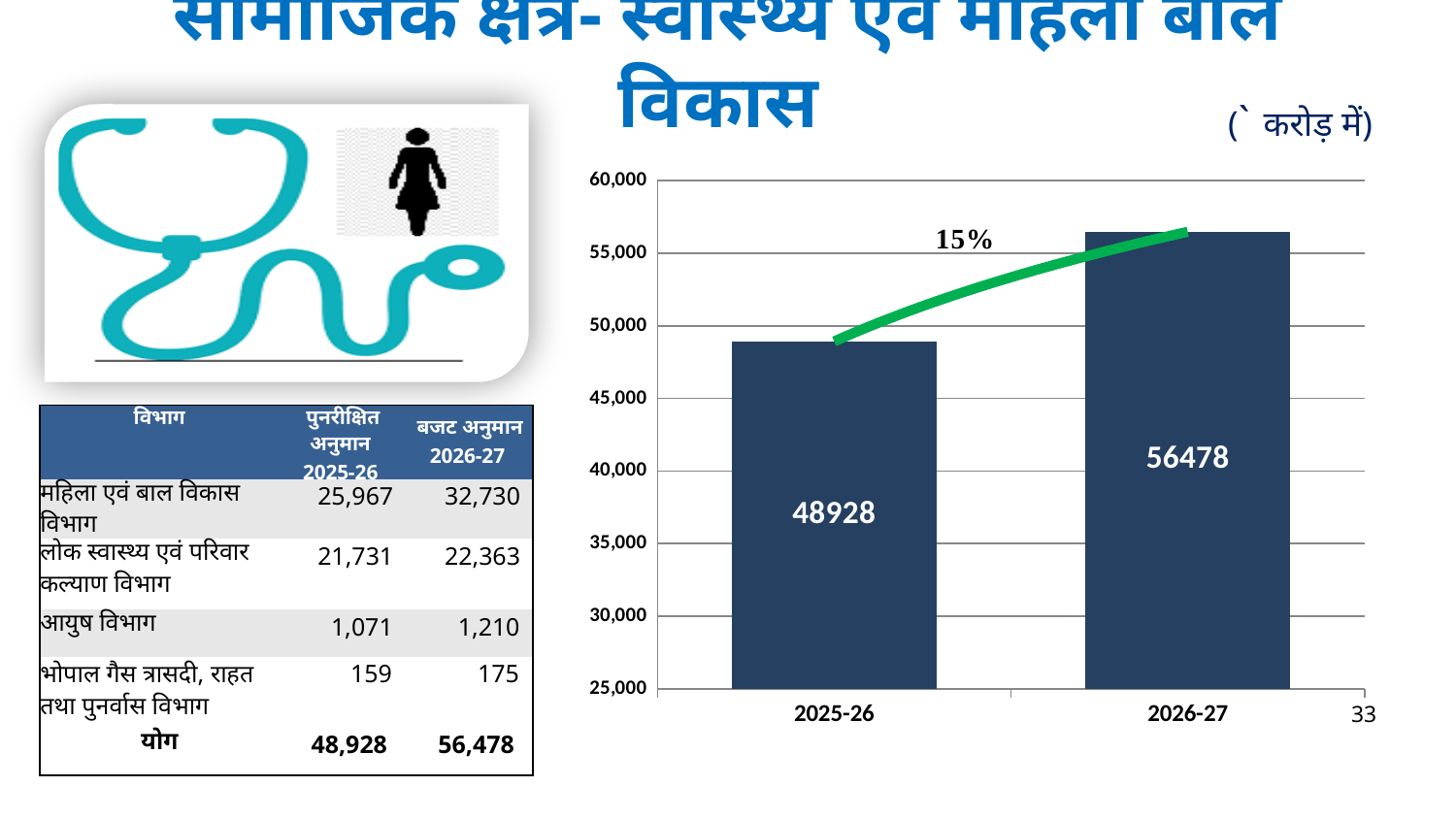
What percentage growth is annotated on the chart between the two bars? 15% How many bars are shown in the chart? 2 What type of chart is shown on the slide? bar chart Which year has the higher value in the bar chart? 2026-27 What is the value for 2026-27 in the bar chart? 56478 Is the value for 2026-27 larger or smaller than the value for 2025-26? larger What is the value for 2025-26 in the bar chart? 48928 Is the value for 2025-26 greater or less than 50,000? less Do the values rise or fall from 2025-26 to 2026-27? rise Which year has the lower value in the bar chart? 2025-26 What is the difference between the 2026-27 and 2025-26 values in the bar chart? 7550 Is the value for 2026-27 greater or less than 55,000? greater